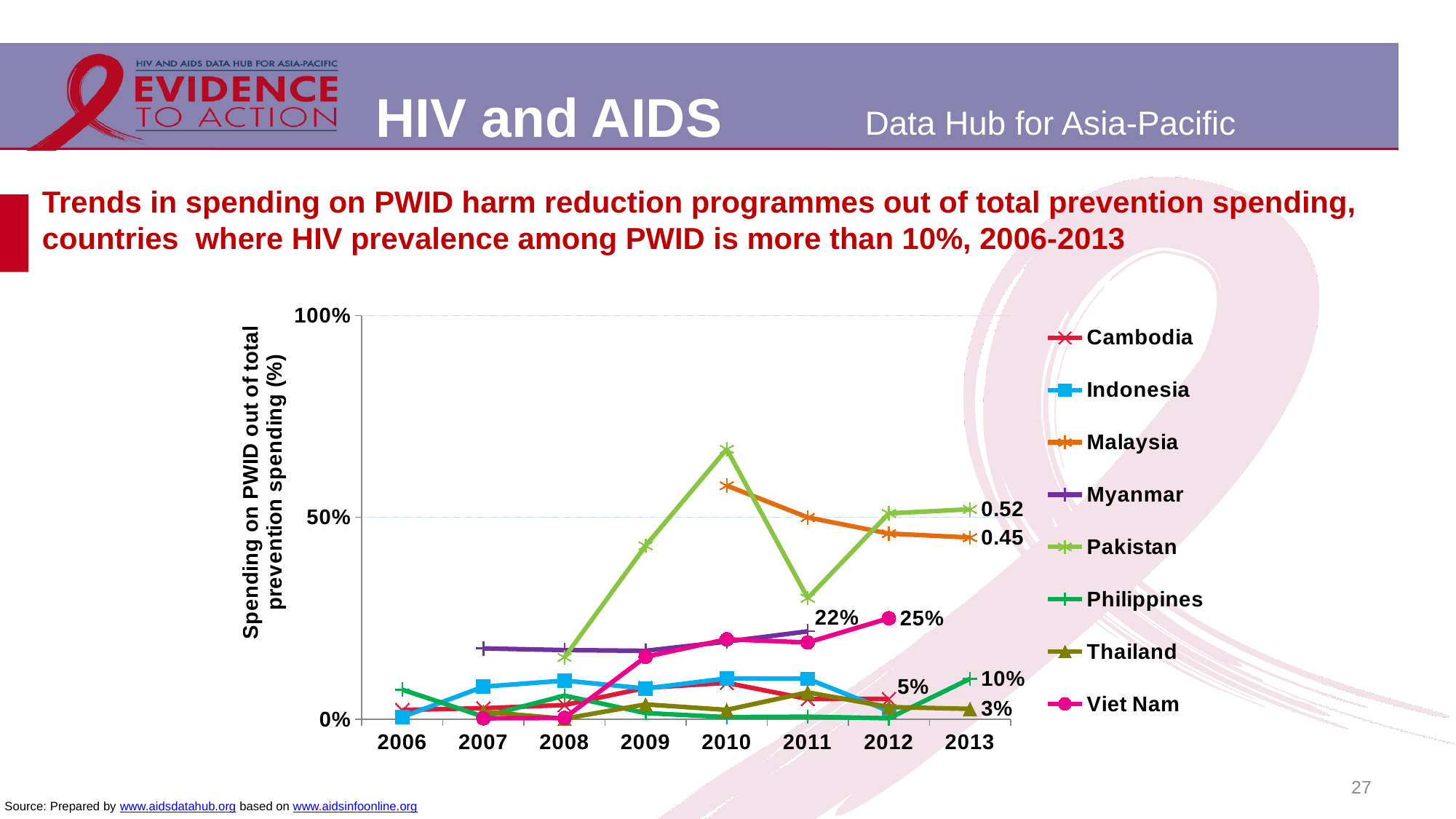
What is the labelled value for the Philippines in 2013? 10% What is the labelled value for Thailand in 2013? 3% What kind of chart is shown on the slide? line chart What is the labelled value for Malaysia in 2013? 0.45 Which country has the higher value in 2013, Pakistan or Malaysia? Pakistan How many countries does the legend list? 8 What is the labelled value for Pakistan in 2013? 0.52 How many years are shown on the x axis? 8 Which country has the highest value in 2010? Pakistan What is the labelled value for Viet Nam in 2012? 25% Is the value for Pakistan in 2010 greater or less than 50%? greater